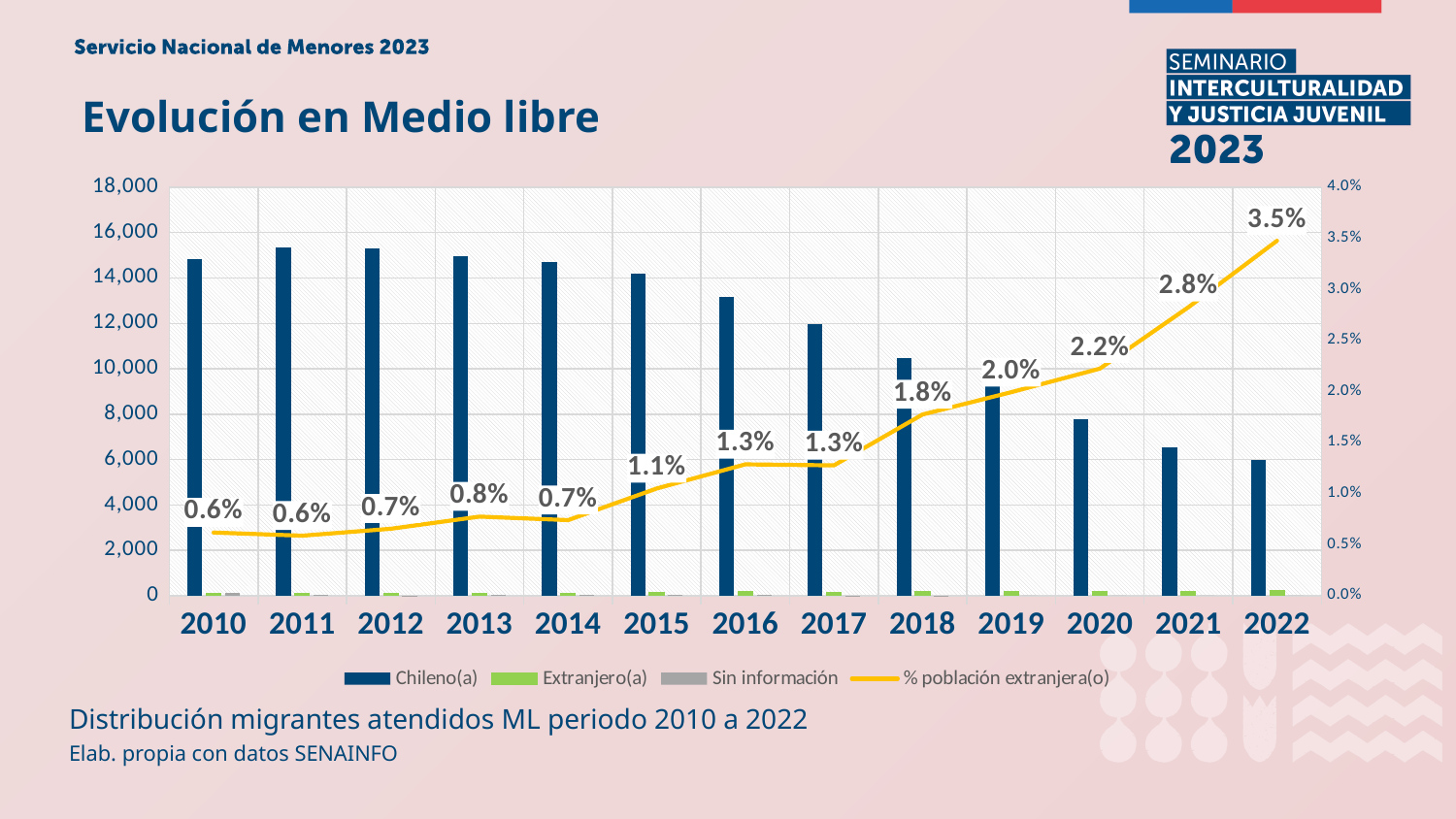
Is the Chileno(a) value for 2010 greater or less than 14,000? greater How many years are shown on the x axis? 13 What is the value of % población extranjera(o) for 2018? 1.8% What is the difference in % población extranjera(o) between 2022 and 2021? 0.7% Is the Chileno(a) value for 2020 greater or less than 8,000? less In which year is % población extranjera(o) highest? 2022 How many series does the legend list? 4 What is the title of the slide containing the chart? Evolución en Medio libre What is the value of % población extranjera(o) for 2022? 3.5% Which is larger, % población extranjera(o) in 2019 or in 2013? 2019 Does the % población extranjera(o) line rise or fall from 2010 to 2022? rise What is the value of % población extranjera(o) for 2015? 1.1%